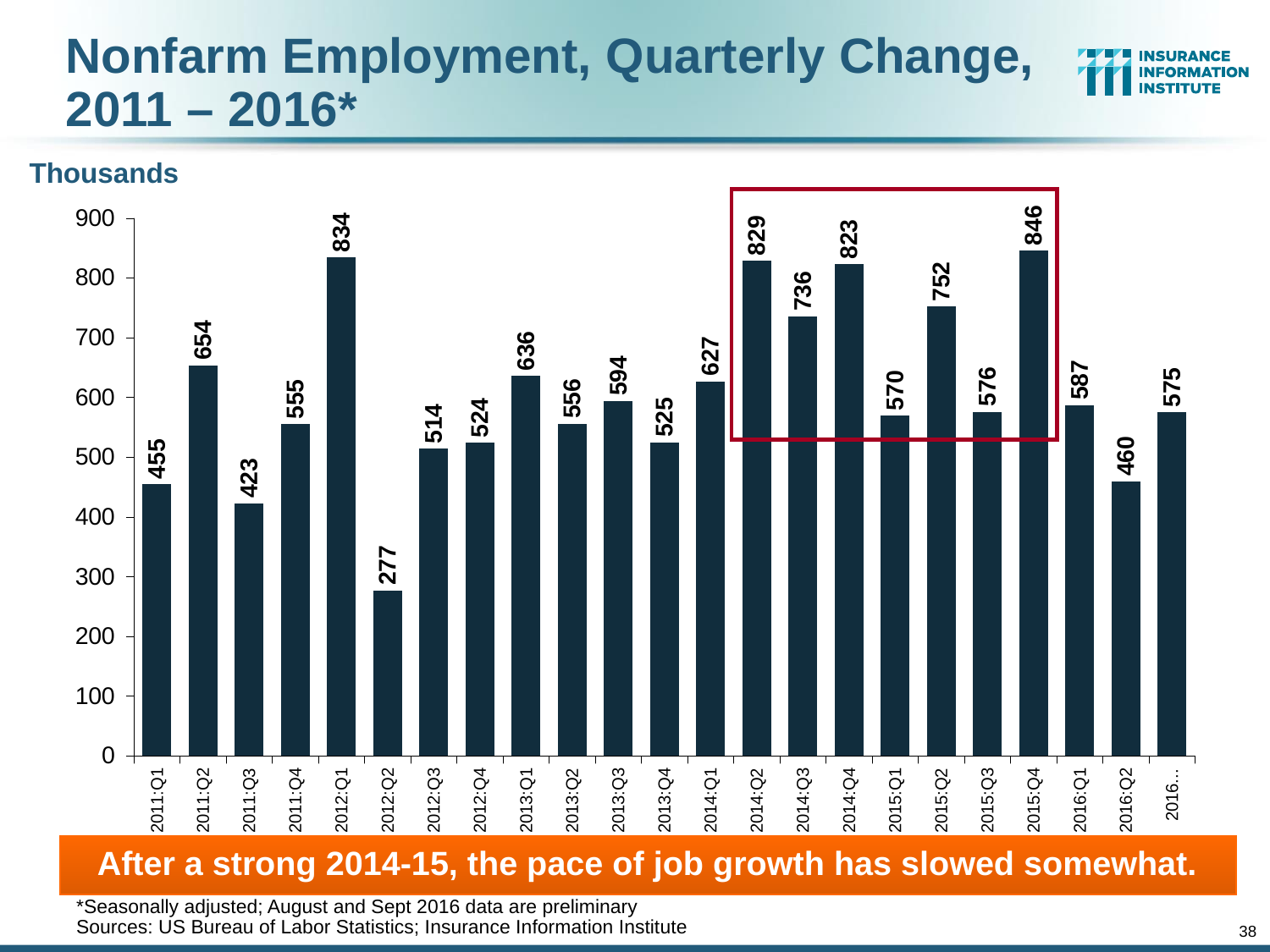
What is the difference between the values for 2014:Q2 and 2014:Q3? 93 What unit is indicated above the chart's y axis? Thousands What is the difference between the values for 2015:Q4 and 2016:Q1? 259 Which quarter has the lowest value? 2012:Q2 How many bars are plotted in the chart? 23 What is the value for 2014:Q3? 736 Which is larger, the value for 2011:Q2 or the value for 2013:Q1? 2011:Q2 Which quarter has the highest value? 2015:Q4 Is the value for 2015:Q2 greater or less than 700? greater What is the value for 2012:Q1? 834 What kind of chart is shown on the slide? Bar chart What is the value for 2016:Q2? 460